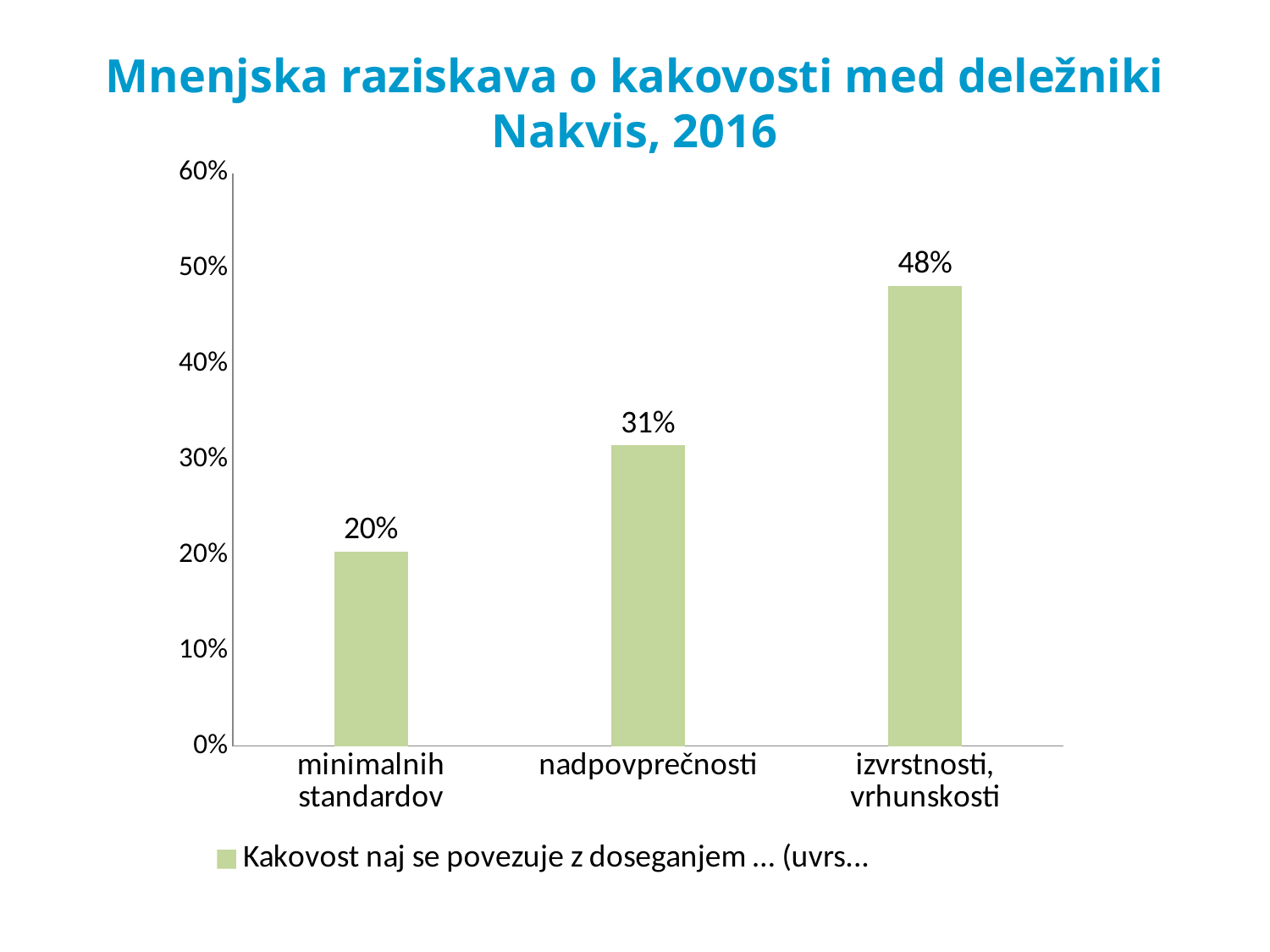
Do the values rise or fall from left to right along the x axis? rise Which category has the highest value? izvrstnosti, vrhunskosti Which is larger, the value for "nadpovprečnosti" or the value for "izvrstnosti, vrhunskosti"? izvrstnosti, vrhunskosti What is the value for "nadpovprečnosti"? 31% What is the difference between the values for "nadpovprečnosti" and "minimalnih standardov"? 11% What kind of chart is shown on the slide? bar chart How many categories are shown on the x axis? 3 What is the difference between the values for "izvrstnosti, vrhunskosti" and "minimalnih standardov"? 28% Is the value for "nadpovprečnosti" greater or less than 40%? less What is the value for "minimalnih standardov"? 20% What is the value for "izvrstnosti, vrhunskosti"? 48% Which category has the lowest value? minimalnih standardov